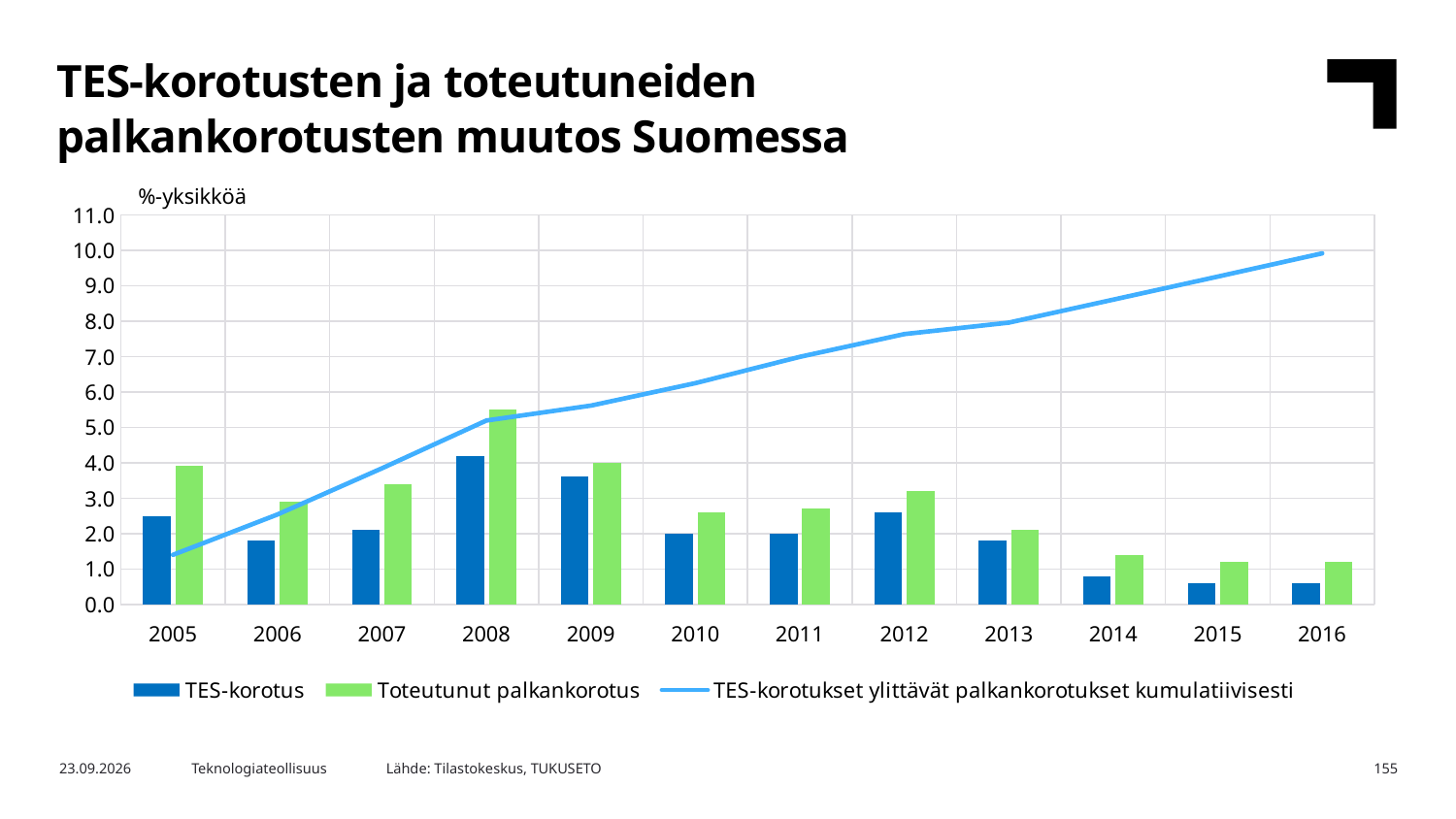
In which year is the TES-korotus bar highest? 2008 Is the Toteutunut palkankorotus value for 2008 greater or less than 5.0? greater What kind of chart is shown on the slide? A combined bar and line chart Does the cumulative line (TES-korotukset ylittävät palkankorotukset kumulatiivisesti) rise or fall from 2005 to 2016? It rises In which year is the Toteutunut palkankorotus bar highest? 2008 Is the value of the cumulative line for 2005 greater or less than 2.0? less Which is larger, the TES-korotus value for 2008 or for 2009? 2008 Is the TES-korotus value for 2014 greater or less than 1.0? less How many series does the legend list? 3 What unit label is shown above the y axis? %-yksikköä How many years are shown on the x axis? 12